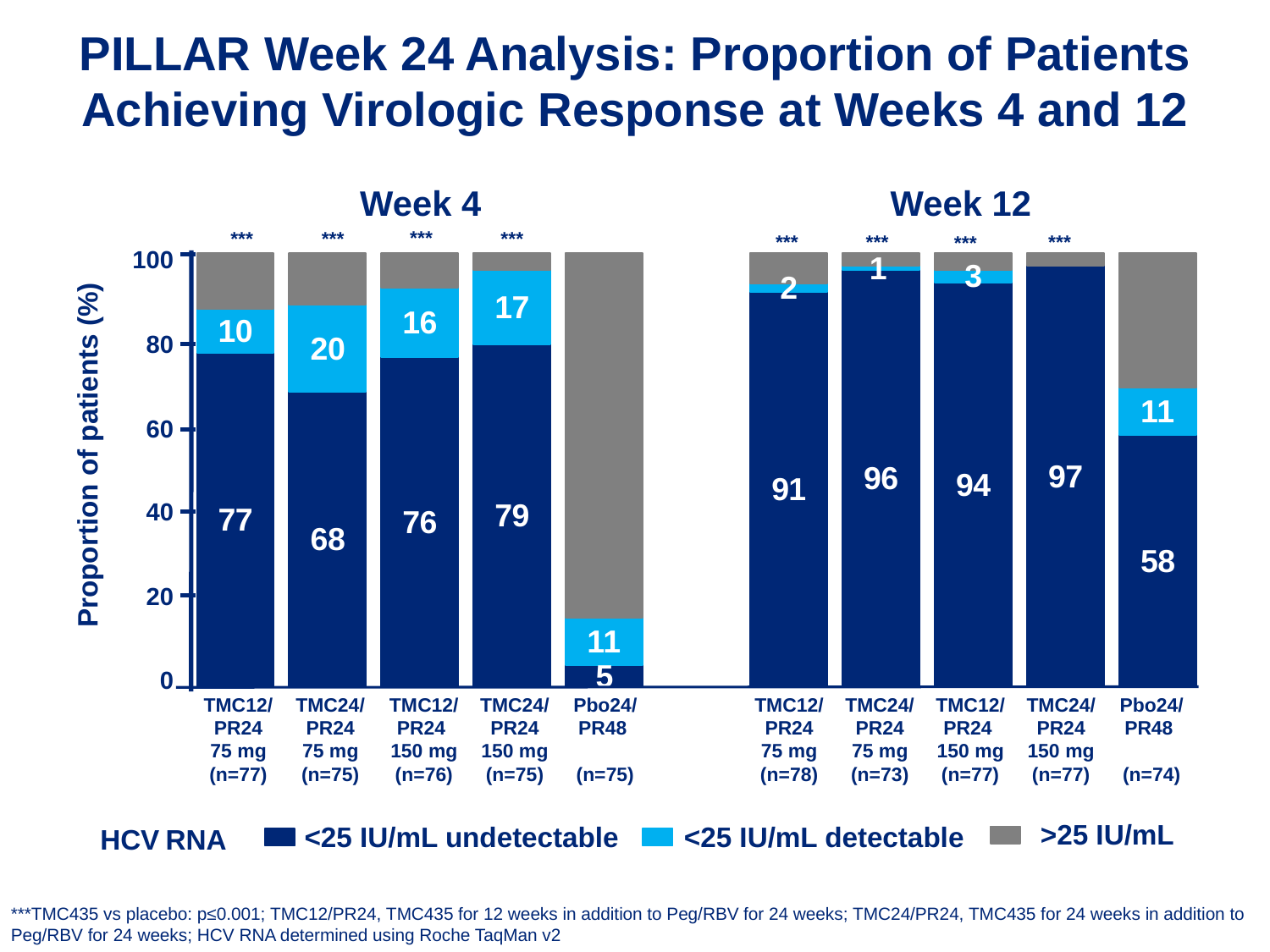
In the Week 12 panel, what is the percentage of patients with <25 IU/mL undetectable HCV RNA for Pbo24/PR48? 58 What type of chart is shown on the slide? bar chart In the Week 12 panel, what is the difference in the <25 IU/mL undetectable percentage between TMC24/PR24 150 mg and Pbo24/PR48? 39 How many series does the HCV RNA legend list? 3 What is the label on the y axis of the chart? Proportion of patients (%) How many treatment groups (bars) are shown in the Week 4 panel? 5 In the Week 4 panel, what is the percentage of patients with <25 IU/mL detectable HCV RNA for Pbo24/PR48? 11 In the Week 4 panel, what is the combined percentage of <25 IU/mL undetectable and <25 IU/mL detectable patients for TMC24/PR24 75 mg? 88 In the Week 4 panel, what is the percentage of patients with <25 IU/mL undetectable HCV RNA for TMC24/PR24 75 mg? 68 In the Week 12 panel, which has a higher <25 IU/mL undetectable percentage: TMC24/PR24 75 mg or TMC12/PR24 75 mg? TMC24/PR24 75 mg In the Week 4 panel, which treatment group has the lowest percentage of patients with <25 IU/mL undetectable HCV RNA? Pbo24/PR48 In the Week 12 panel, which treatment group has the highest percentage of patients with <25 IU/mL undetectable HCV RNA? TMC24/PR24 150 mg